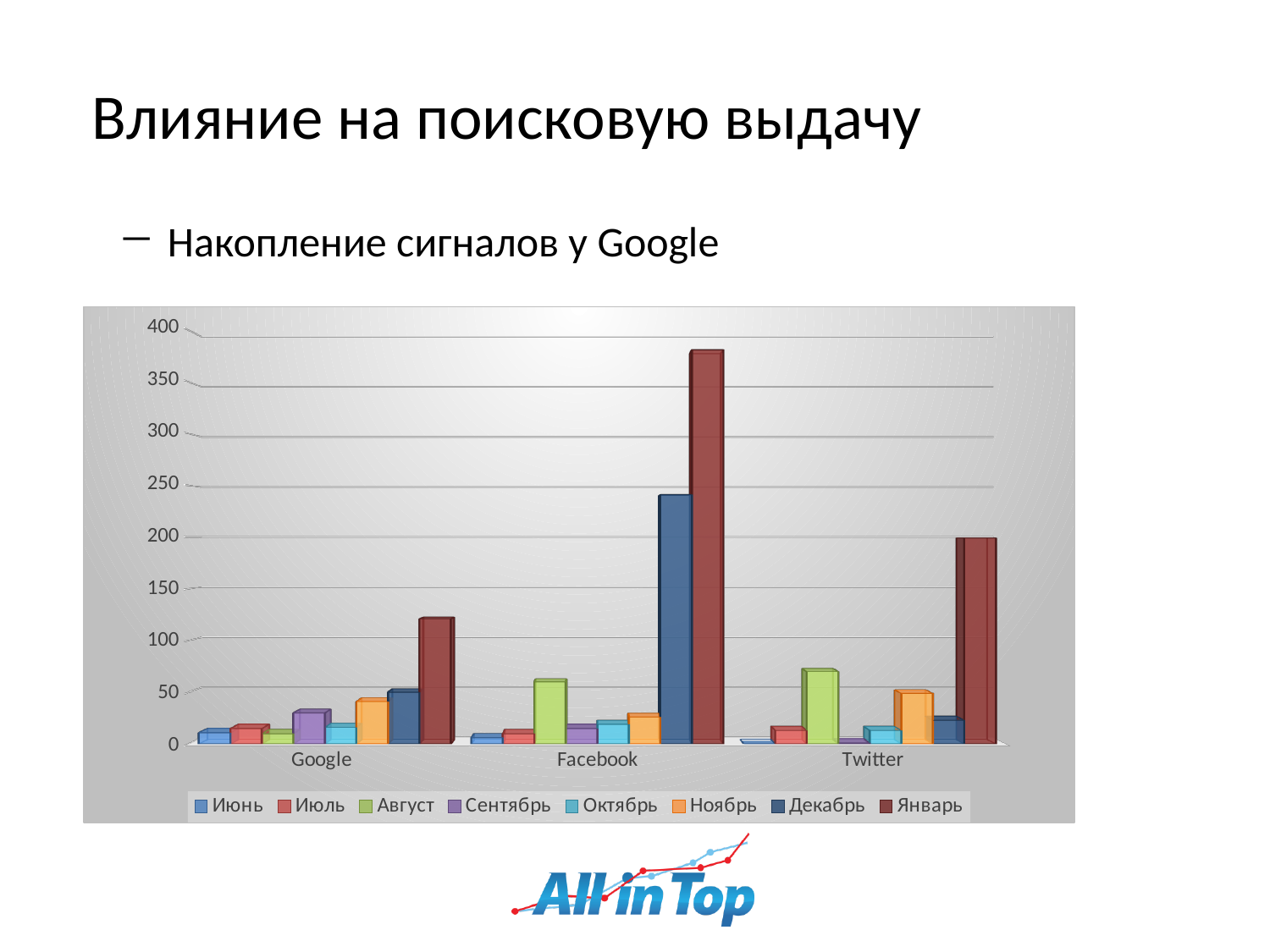
How many categories are shown on the x axis of the chart? 3 Is the value for Facebook in Январь greater or less than 350? greater What kind of chart is shown on the slide? bar chart What is the first entry in the chart's legend? Июнь Is the value for Twitter in Январь greater or less than 150? greater Which category has the lowest value for Январь? Google How many series does the chart's legend list? 8 Is the value for Google in Январь greater or less than 100? greater Which is larger for Twitter: the Август value or the Июль value? Август Which is larger: the Декабрь value for Facebook or the Декабрь value for Google? Facebook Which category has the highest value for Январь? Facebook